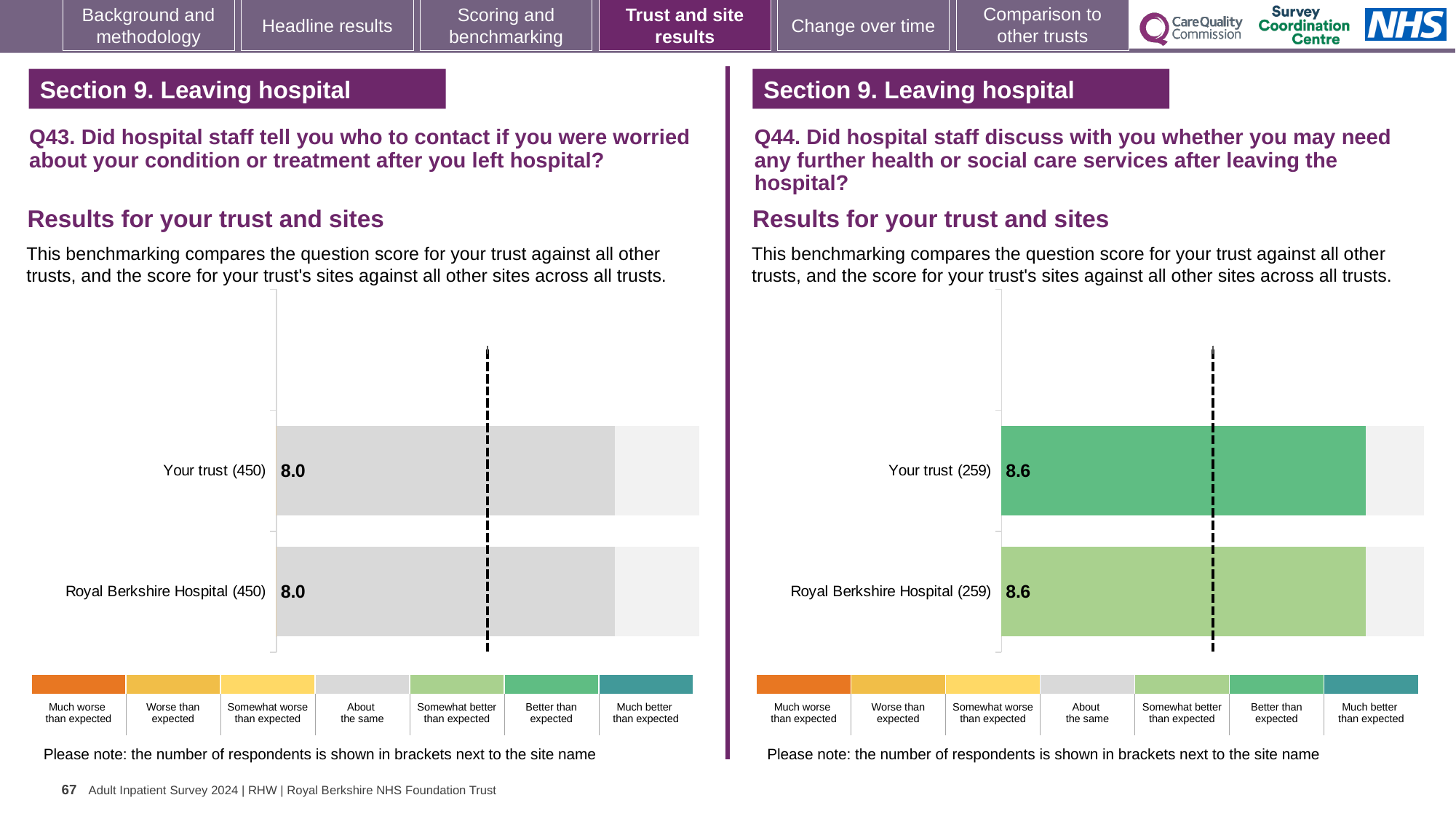
In the Q44 chart on the right, what is the score for Your trust? 8.6 In the Q44 chart on the right, how many respondents are shown in brackets for Royal Berkshire Hospital? 259 How many bars are plotted in the Q43 chart on the left? 2 In the Q44 chart on the right, what is the score for Royal Berkshire Hospital? 8.6 What kind of chart is the Q43 chart on the left? Bar chart In the Q43 chart on the left, which benchmark category does the colour of the Royal Berkshire Hospital bar correspond to according to the legend? About the same How many bars are plotted in the Q44 chart on the right? 2 In the Q43 chart on the left, what is the score for Royal Berkshire Hospital? 8.0 In the Q44 chart on the right, which benchmark category does the colour of the Your trust bar correspond to according to the legend? Better than expected In the Q43 chart on the left, what is the score for Your trust? 8.0 In the Q44 chart on the right, what is the difference between the score for Your trust and the score for Royal Berkshire Hospital? 0.0 In the Q43 chart on the left, how many respondents are shown in brackets for Your trust? 450